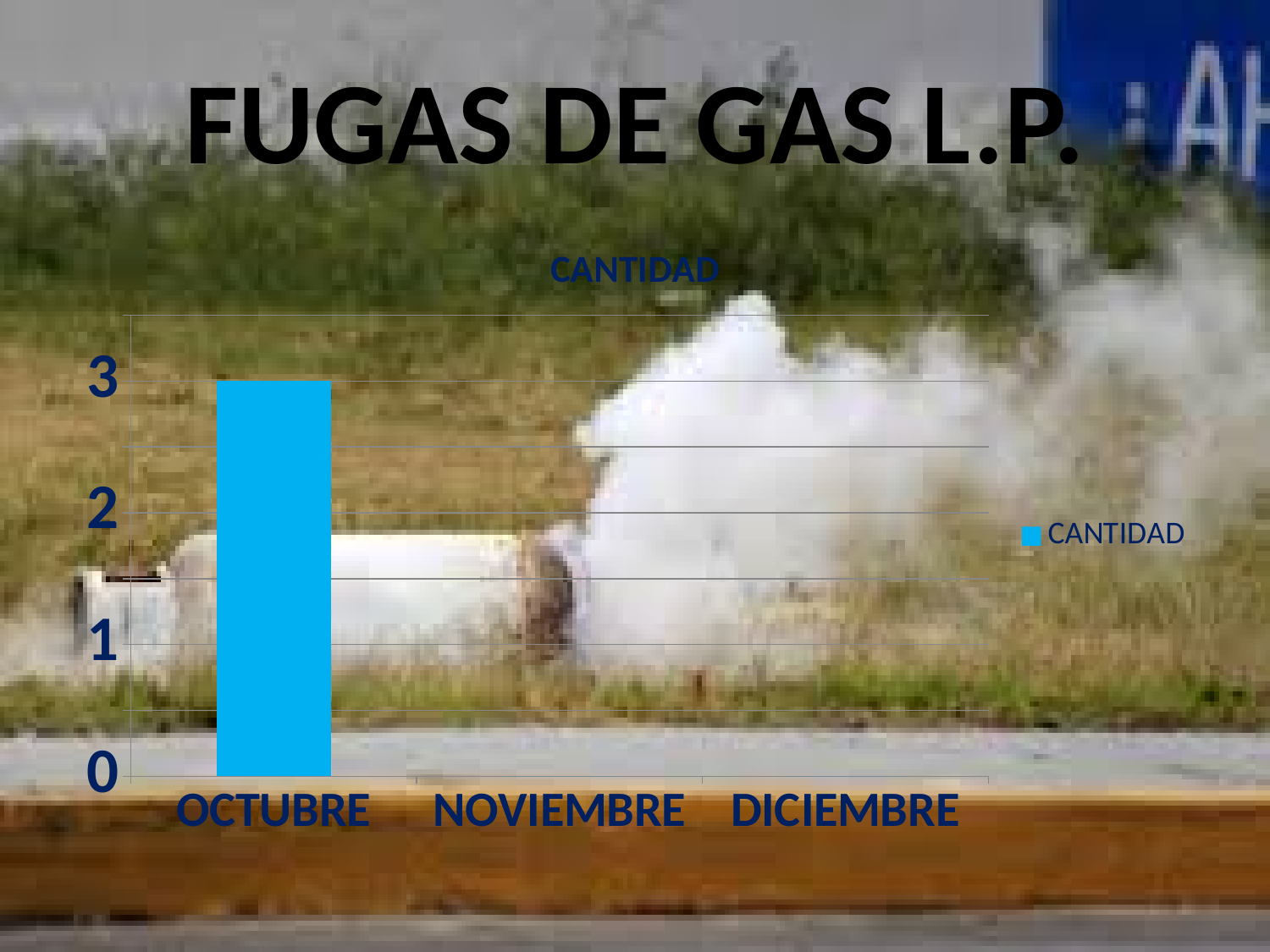
How many series does the legend list? 1 What is the name of the series listed in the legend? CANTIDAD What is the value for OCTUBRE? 3 What kind of chart is shown on the slide? bar chart Which category has the highest value? OCTUBRE Is the value for OCTUBRE greater or less than 2? greater Which is larger, the value for OCTUBRE or the value for NOVIEMBRE? OCTUBRE Which is larger, the value for OCTUBRE or the value for DICIEMBRE? OCTUBRE What is the title of the chart? CANTIDAD How many categories are shown on the x axis? 3